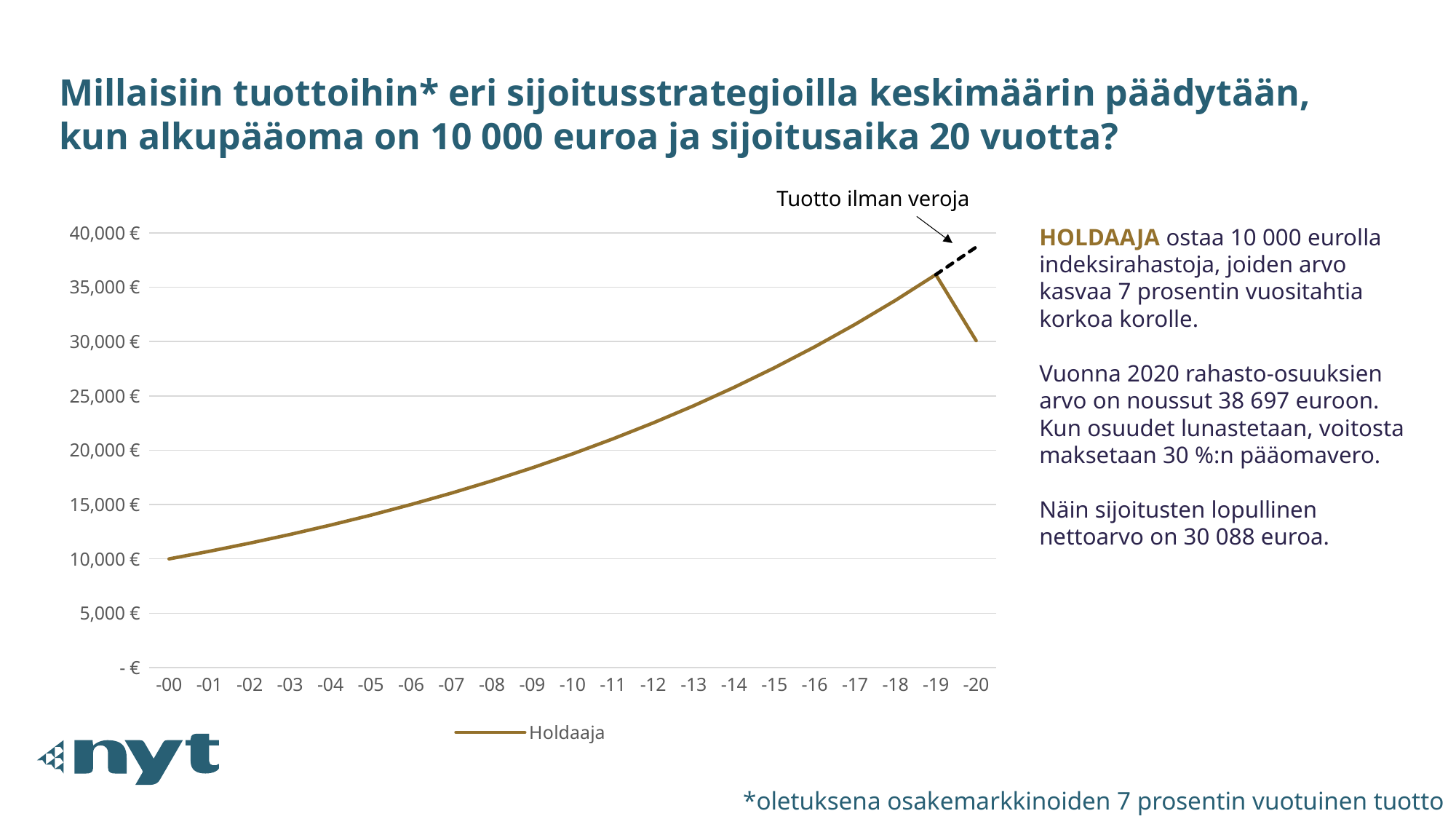
What is the name of the series shown in the legend? Holdaaja What is the value of the Holdaaja line at -00? 10,000 € Does the Holdaaja line rise or fall from -00 to -19? rises At which x-axis label is the Holdaaja line at its lowest value? -00 What kind of chart is shown on the slide? line chart What does the annotation pointing to the dashed line at the end of the chart say? Tuotto ilman veroja How many points are plotted along the x axis (from -00 to -20)? 21 Is the Holdaaja value at -15 greater or less than 25,000 €? greater How many series does the legend list? 1 Which is larger, the Holdaaja value at -19 or at -20? -19 Is the Holdaaja value at -05 greater or less than 15,000 €? less At which x-axis label does the Holdaaja line reach its highest value? -19